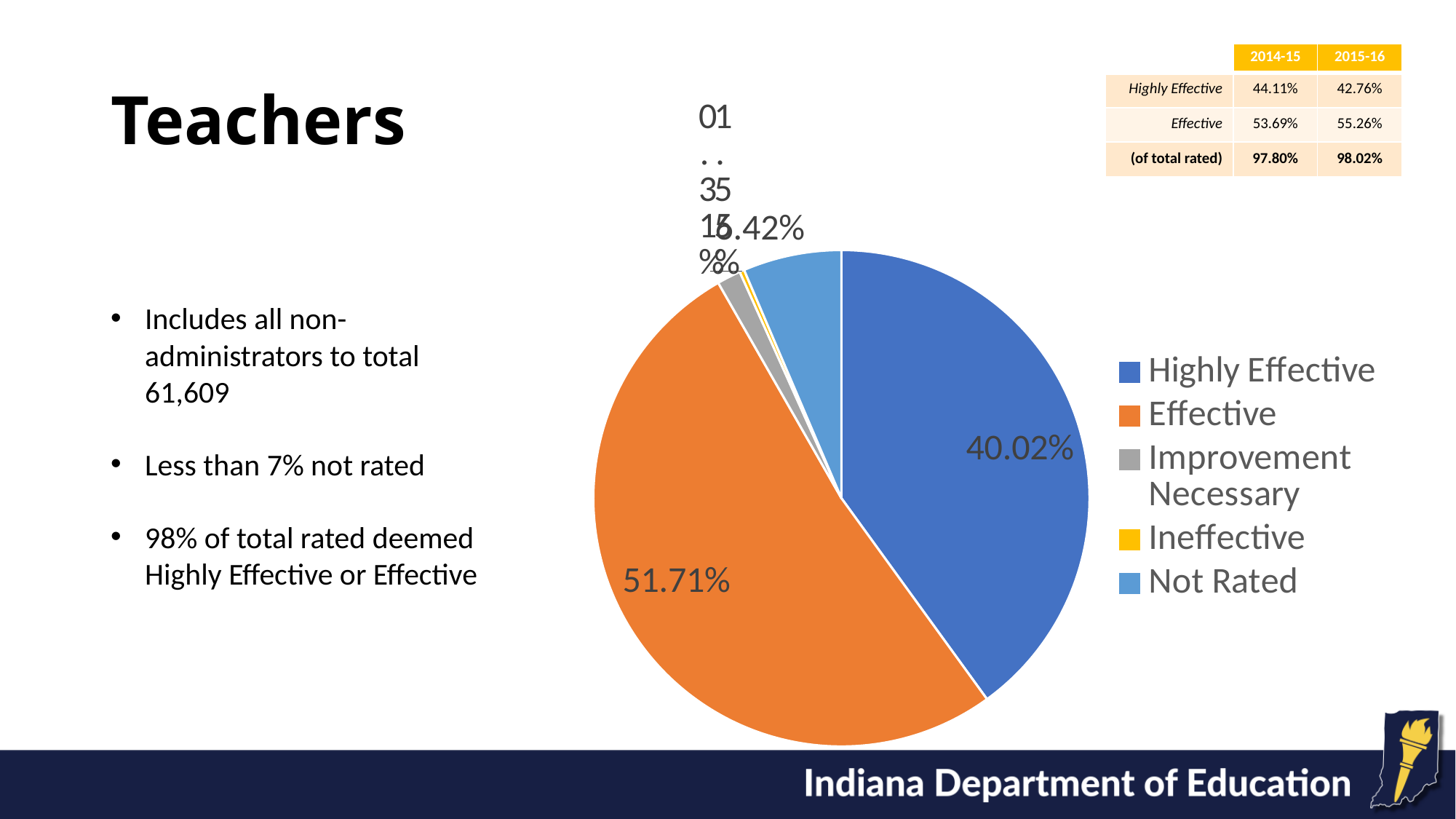
What share of the pie is labelled for Highly Effective? 40.02% Which category has the smallest slice of the pie? Ineffective Which category has the largest slice of the pie? Effective What is the difference between the Effective and Highly Effective shares? 11.69% What kind of chart is shown on the slide? pie chart What colour is the Effective slice in the pie chart? orange How many categories does the pie chart's legend list? 5 What share of the pie is labelled for Not Rated? 6.42% Which slice is larger, Effective or Highly Effective? Effective What share of the pie is labelled for Effective? 51.71% Which slice is larger, Not Rated or Improvement Necessary? Not Rated What colour is the Ineffective slice in the pie chart? yellow